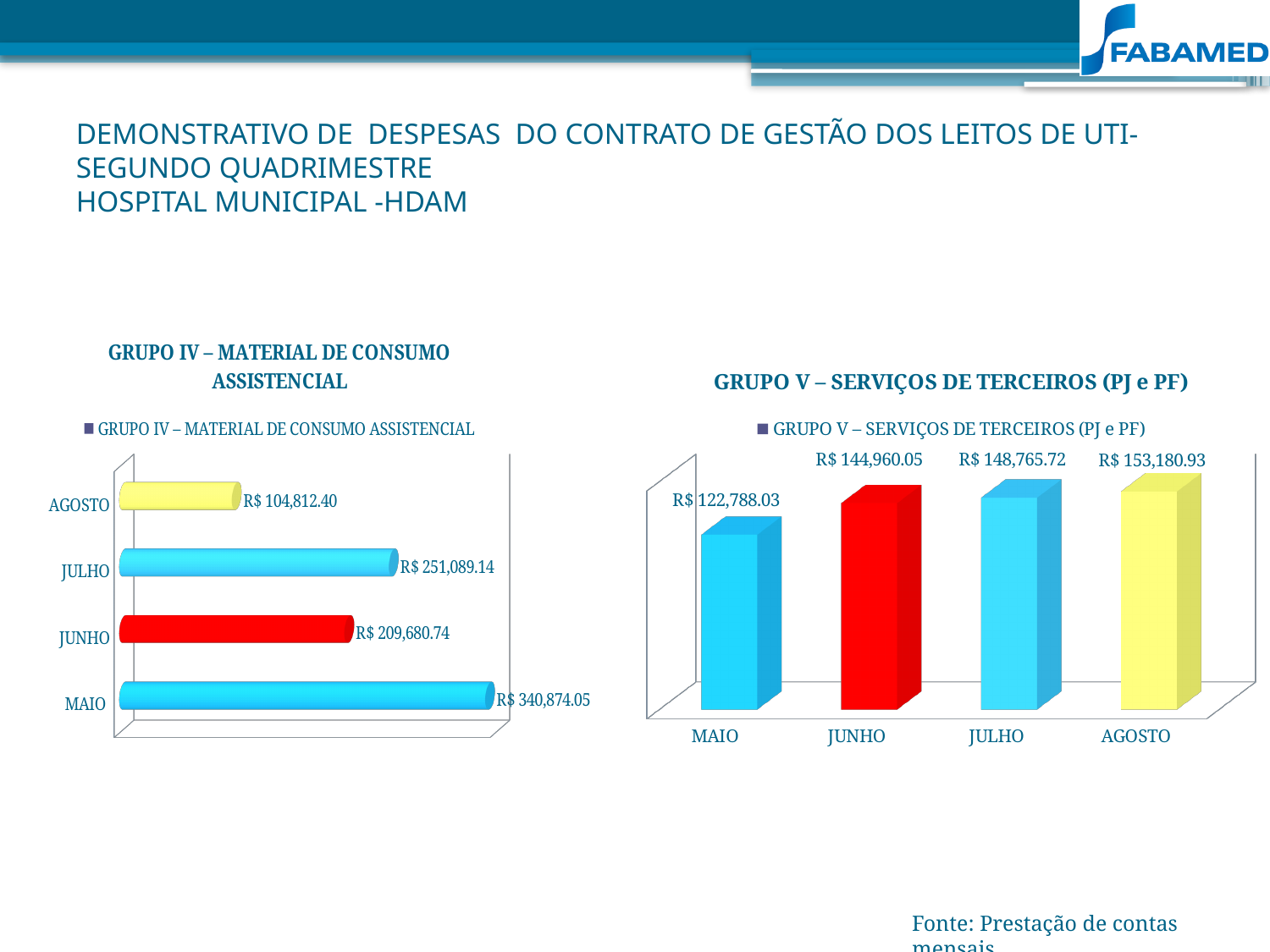
In the GRUPO IV – MATERIAL DE CONSUMO ASSISTENCIAL chart, what is the value for MAIO? R$ 340,874.05 What kind of chart is the GRUPO IV – MATERIAL DE CONSUMO ASSISTENCIAL chart? Bar chart In the GRUPO V – SERVIÇOS DE TERCEIROS (PJ e PF) chart, which month has the highest value? AGOSTO In the GRUPO IV – MATERIAL DE CONSUMO ASSISTENCIAL chart, what is the difference between the values for MAIO and AGOSTO? R$ 236,061.65 In the GRUPO IV – MATERIAL DE CONSUMO ASSISTENCIAL chart, which month has the lowest value? AGOSTO In the GRUPO IV – MATERIAL DE CONSUMO ASSISTENCIAL chart, what is the value for AGOSTO? R$ 104,812.40 In the GRUPO V – SERVIÇOS DE TERCEIROS (PJ e PF) chart, what is the value for JUNHO? R$ 144,960.05 In the GRUPO V – SERVIÇOS DE TERCEIROS (PJ e PF) chart, what is the difference between the values for AGOSTO and MAIO? R$ 30,392.90 In the GRUPO IV – MATERIAL DE CONSUMO ASSISTENCIAL chart, which is larger, the value for JULHO or the value for JUNHO? JULHO In the GRUPO V – SERVIÇOS DE TERCEIROS (PJ e PF) chart, do the values rise or fall from MAIO to AGOSTO? Rise How many months are shown in the GRUPO V – SERVIÇOS DE TERCEIROS (PJ e PF) chart? 4 In the GRUPO IV – MATERIAL DE CONSUMO ASSISTENCIAL chart, which month has the highest value? MAIO